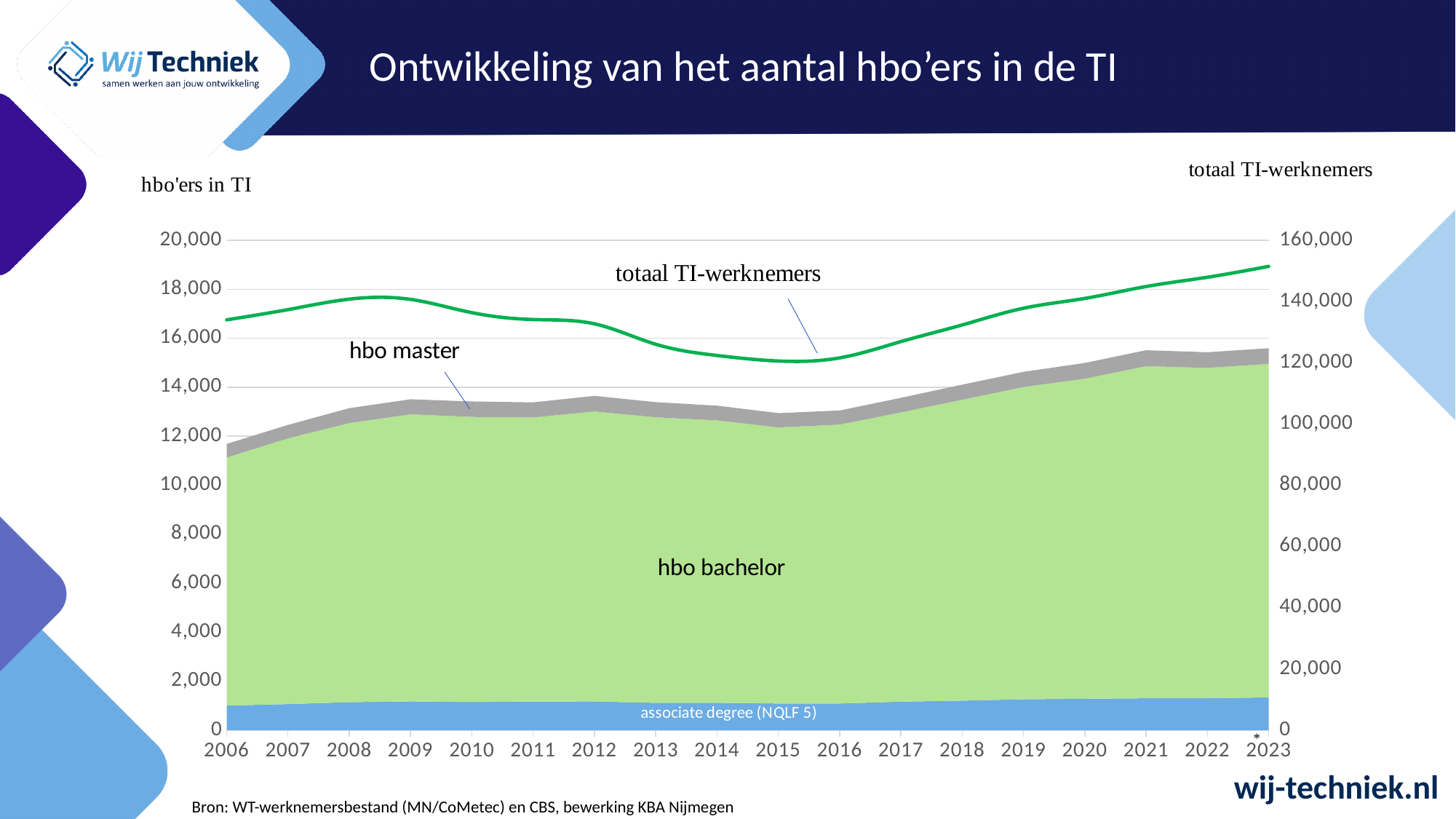
What kind of chart is shown on the slide? Stacked area chart with a line Which year has the highest value for totaal TI-werknemers? 2023 How many years are shown along the x axis of the chart? 18 What is the label of the left vertical axis? hbo'ers in TI How many data series are labelled on the chart? 4 Is the total number of hbo'ers in TI in 2023 greater or less than 14,000? greater Is the value for totaal TI-werknemers in 2023 greater or less than 140,000? greater Is the value for totaal TI-werknemers in 2006 greater or less than 120,000? greater Which year has the lowest total number of hbo'ers in TI? 2006 What is the title of the chart on the slide? Ontwikkeling van het aantal hbo'ers in de TI Does the totaal TI-werknemers line rise or fall between 2015 and 2023? rise